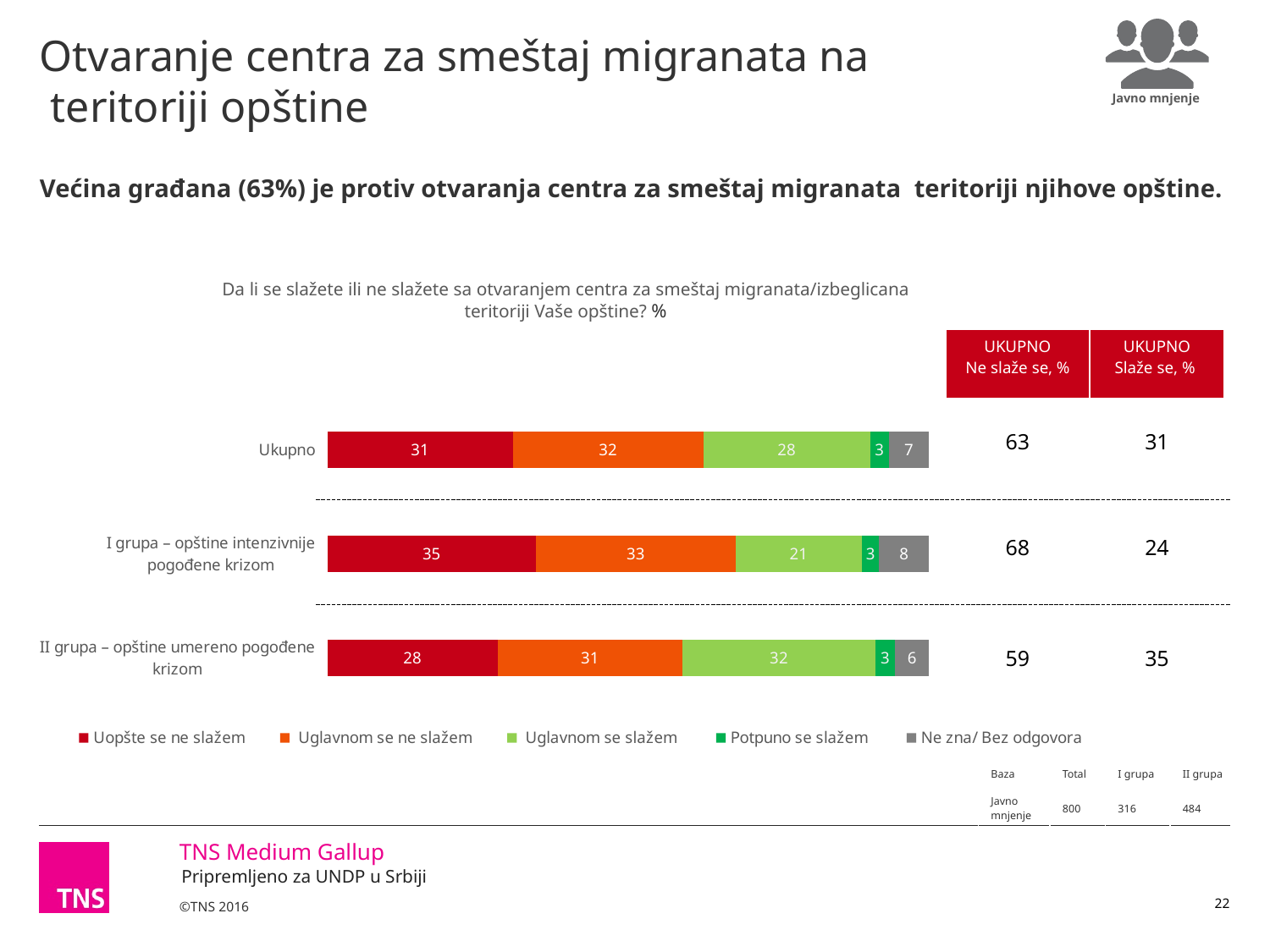
What is the value for "Ne zna/ Bez odgovora" in the "II grupa – opštine umereno pogođene krizom" bar? 6 What kind of chart is shown on the slide? Stacked bar chart What is the value for "Uglavnom se slažem" in the "I grupa – opštine intenzivnije pogođene krizom" bar? 21 What is the value for "Uopšte se ne slažem" in the Ukupno bar? 31 Which category has the lowest value for "Uglavnom se slažem"? I grupa – opštine intenzivnije pogođene krizom What is the total of the stacked bar for "I grupa – opštine intenzivnije pogođene krizom"? 100 Which category has the highest value for "Uopšte se ne slažem"? I grupa – opštine intenzivnije pogođene krizom Which has a larger "Uglavnom se slažem" value, Ukupno or II grupa? II grupa – opštine umereno pogođene krizom What colour represents "Uopšte se ne slažem" in the chart? Red How many categories (bars) are shown in the chart? 3 What is the difference between the "Uglavnom se ne slažem" values for I grupa and II grupa? 2 How many series does the legend list? 5